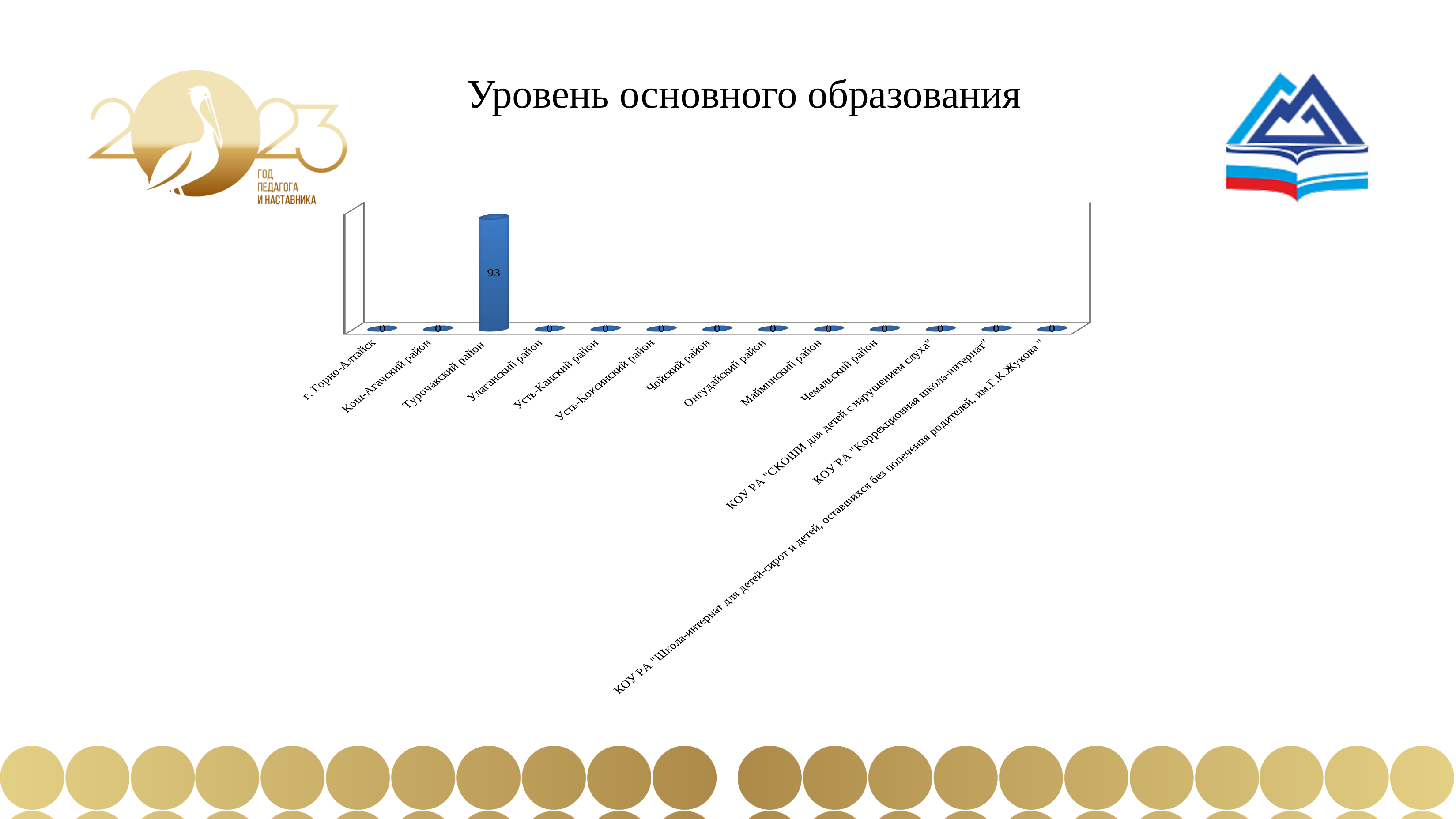
What kind of chart is shown on the slide? Bar chart How many categories are shown on the x axis? 13 What is the value for Майминский район? 0 Which is larger, the value for Турочакский район or the value for Кош-Агачский район? Турочакский район What is the value for Чемальский район? 0 What is the title of the slide? Уровень основного образования Which category has the highest value? Турочакский район What is the difference between the values for Турочакский район and Улаганский район? 93 What is the value for Турочакский район? 93 How many categories have a value of 0? 12 What is the value for г. Горно-Алтайск? 0 What colour are the bars in the chart? Blue